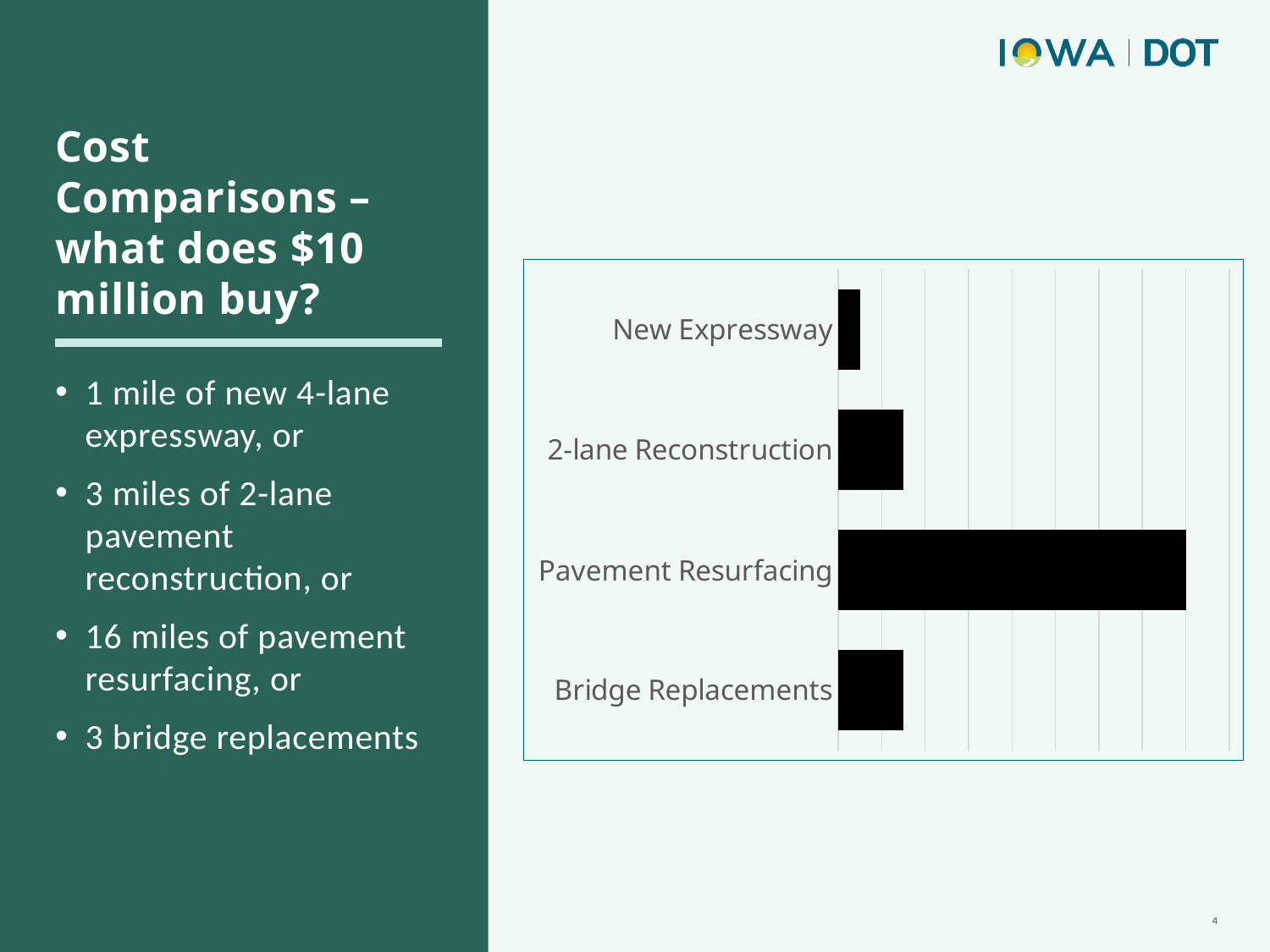
Which category has the shortest bar in the chart? New Expressway Which bar is longer: Pavement Resurfacing or Bridge Replacements? Pavement Resurfacing Which category has the longest bar in the chart? Pavement Resurfacing Which bar is longer: New Expressway or Bridge Replacements? Bridge Replacements Which bar is longer: Pavement Resurfacing or 2-lane Reconstruction? Pavement Resurfacing Are the bars in the chart drawn horizontally or vertically? horizontally What kind of chart is shown on the slide? bar chart Which category is listed at the top of the chart? New Expressway What colour are the bars in the chart? black How many categories does the chart show? 4 Which category is listed at the bottom of the chart? Bridge Replacements